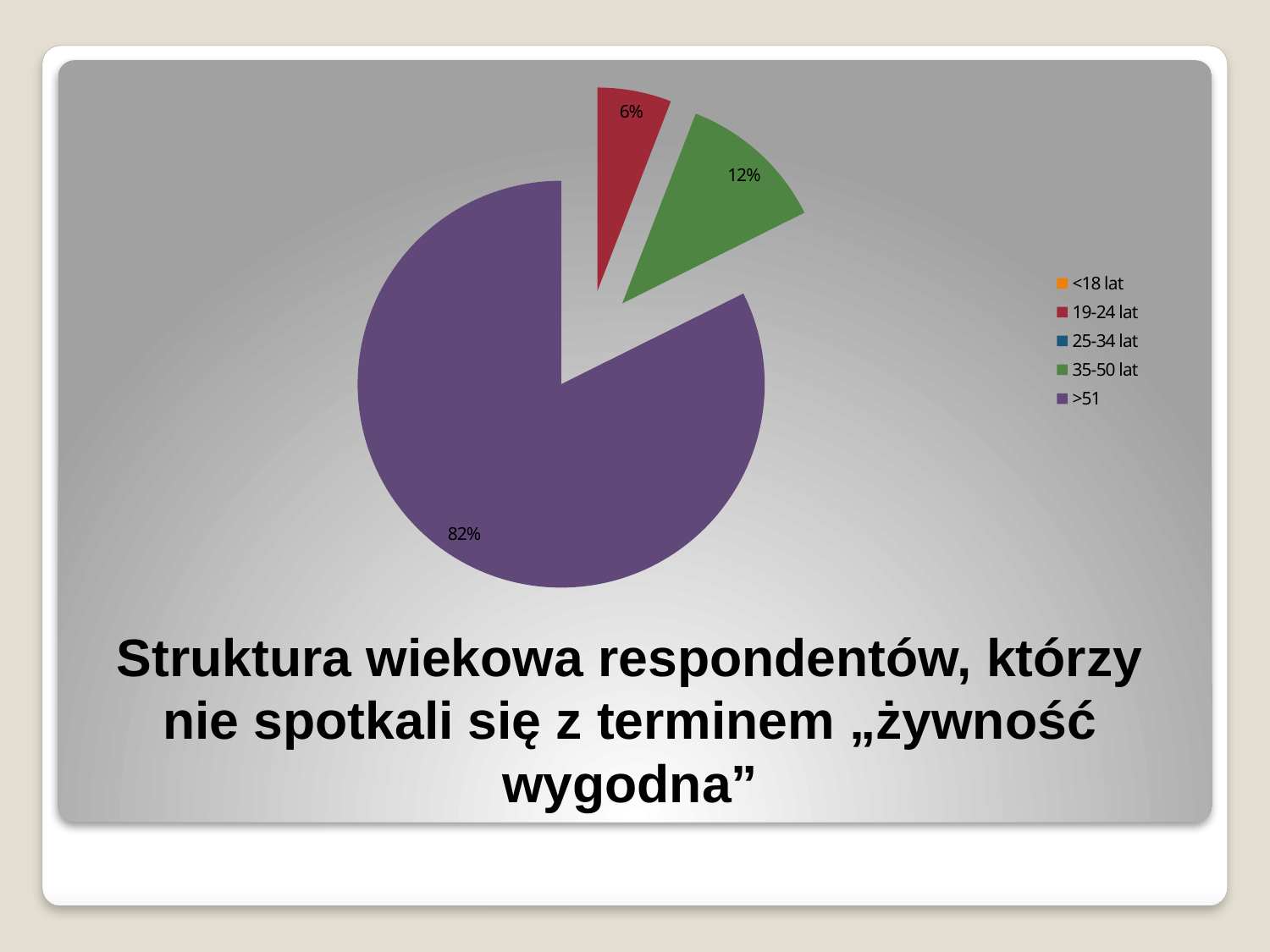
What is the difference in percentage points between the 35-50 lat slice and the 19-24 lat slice? 6 Which age group has the largest share of the pie? >51 How many slices with data labels are visible in the pie? 3 How many age groups are listed in the legend? 5 What is the difference in percentage points between the >51 slice and the 35-50 lat slice? 70 Which slice is larger, 35-50 lat or 19-24 lat? 35-50 lat What percentage of respondents are in the >51 age group? 82% What percentage of respondents are in the 19-24 lat age group? 6% What colour is the slice representing the >51 age group? purple What type of chart is shown on the slide? pie chart Which of the labelled slices has the smallest share of the pie? 19-24 lat What percentage of respondents are in the 35-50 lat age group? 12%